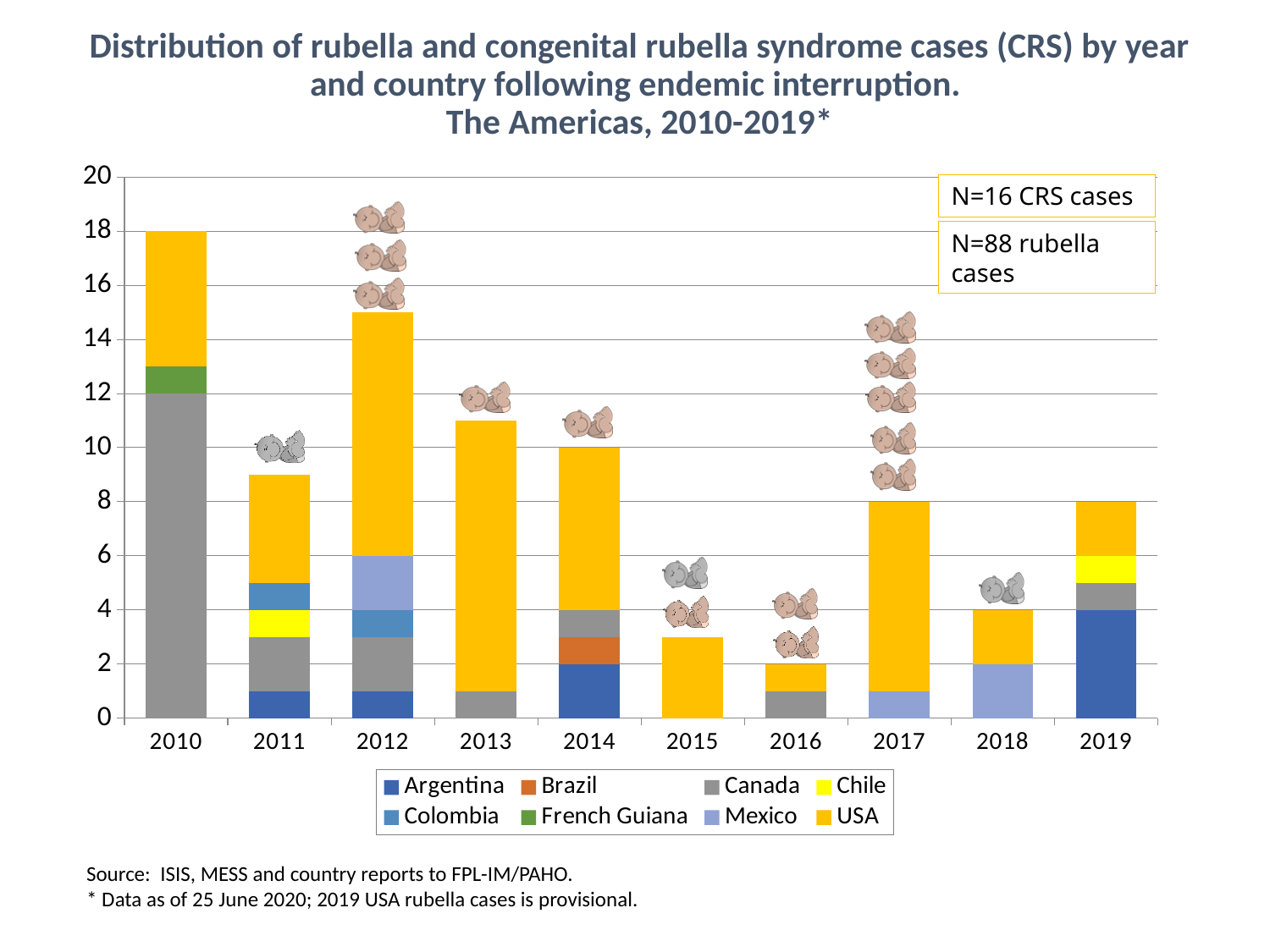
What is the total height of the stacked bar for 2010? 18 Which year has the lowest total number of cases? 2016 Is the total for 2012 greater or less than 14? greater Which year has a larger total, 2012 or 2013? 2012 How many countries does the legend list? 8 How many years are shown along the x axis of the chart? 10 What is the total height of the stacked bar for 2017? 8 What is the value for Canada in 2010? 12 What kind of chart is shown on the slide? Stacked bar chart Which year has the highest total number of cases? 2010 What is the value for Argentina in 2019? 4 Do the total cases rise or fall from 2012 to 2016? Fall